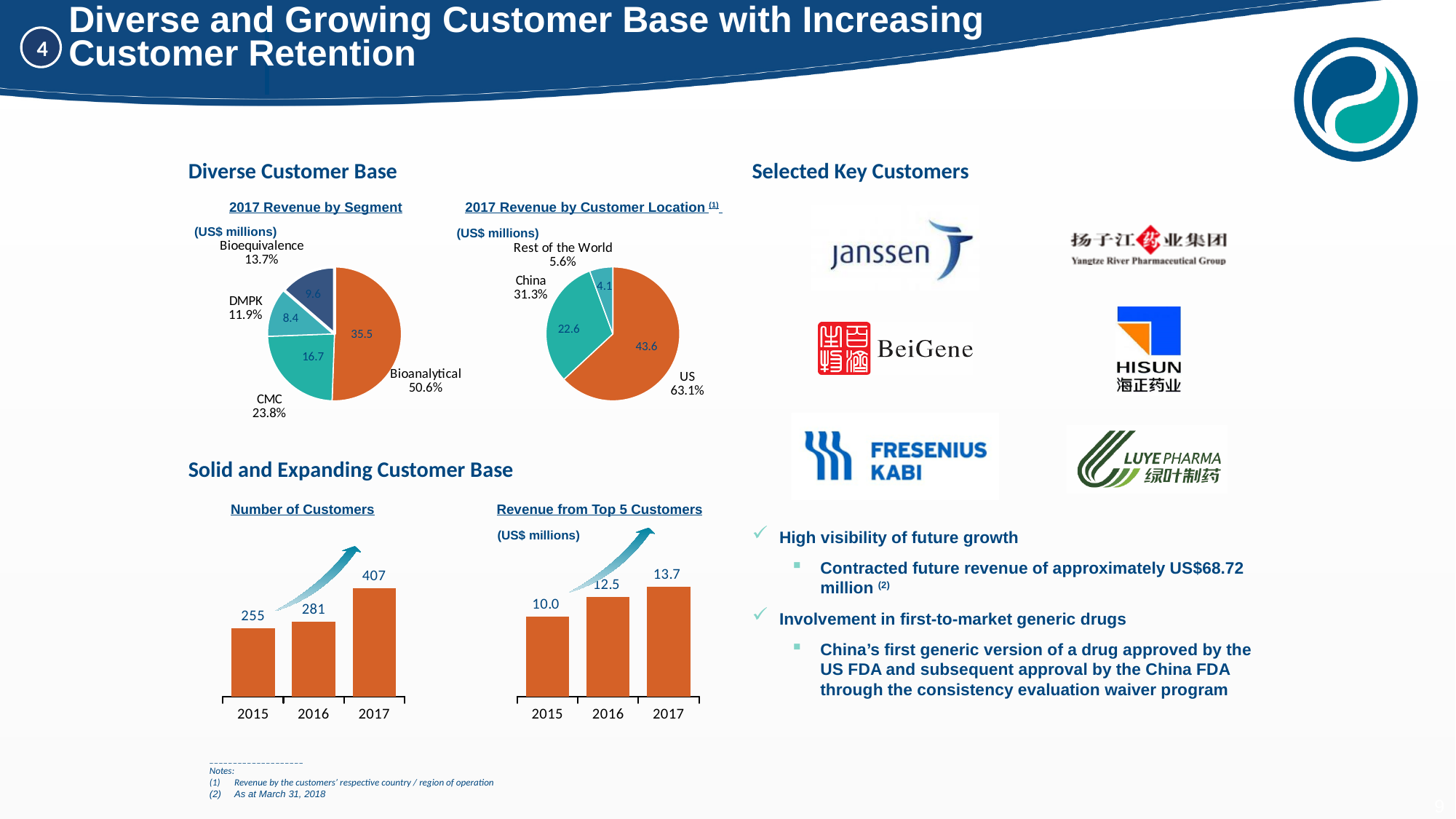
In the '2017 Revenue by Customer Location' pie chart, what is the difference between the US and China values? 21.0 In the '2017 Revenue by Segment' pie chart, what share of revenue does CMC represent? 23.8% In the '2017 Revenue by Customer Location' pie chart, what is the value for China? 22.6 In the '2017 Revenue by Segment' pie chart, how many segments are shown? 4 In the 'Number of Customers' chart, what is the value for 2017? 407 In the '2017 Revenue by Segment' pie chart, which segment has the smallest value? DMPK What type of chart is the 'Number of Customers' chart? bar chart In the 'Revenue from Top 5 Customers' chart, do the values rise or fall from 2015 to 2017? rise In the '2017 Revenue by Segment' pie chart, what is the value for Bioanalytical? 35.5 In the 'Revenue from Top 5 Customers' chart, what is the value for 2016? 12.5 In the '2017 Revenue by Customer Location' pie chart, what share of revenue comes from the US? 63.1% In the 'Number of Customers' chart, what is the difference between 2017 and 2015? 152